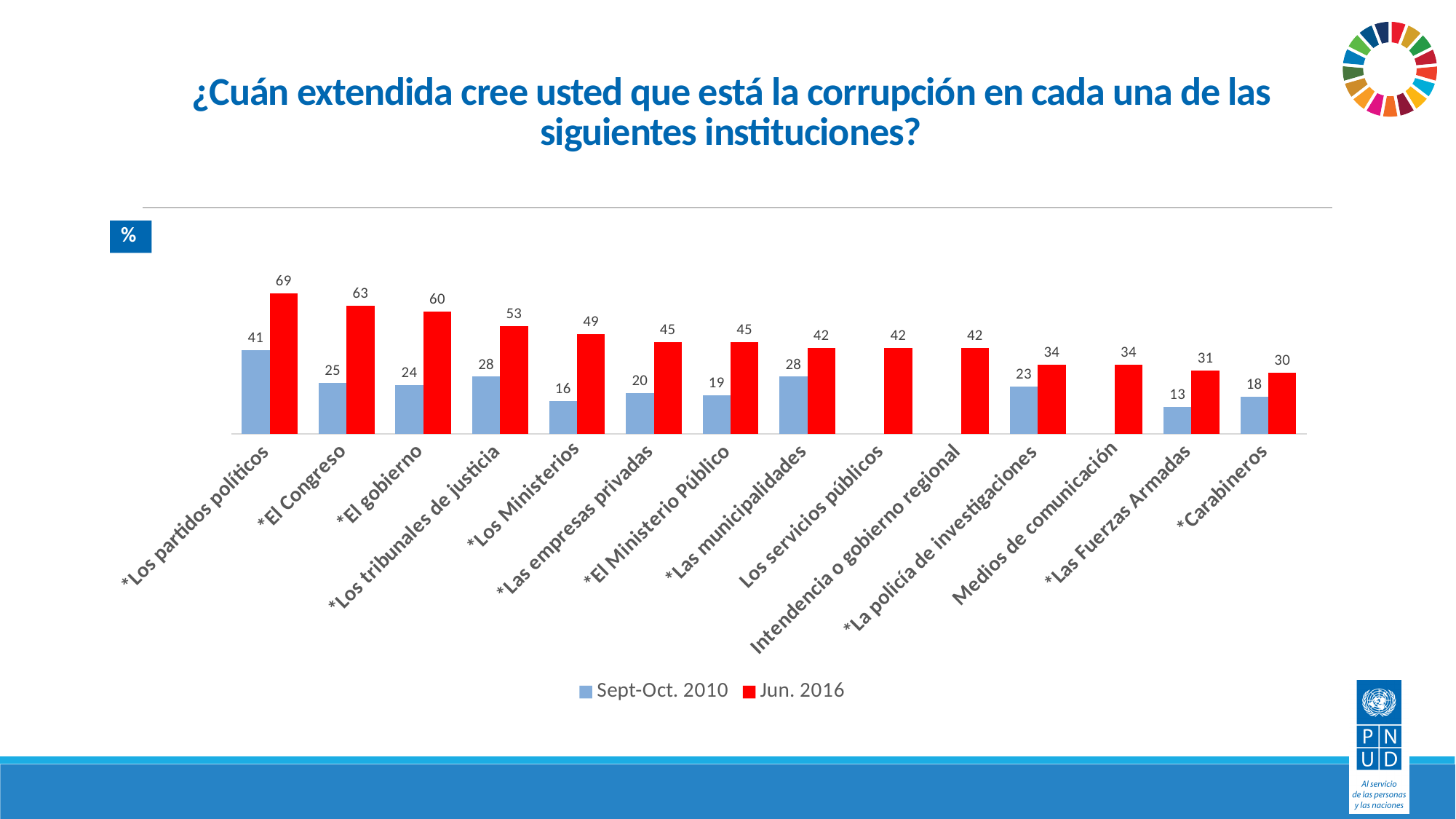
Which category has the highest Jun. 2016 value? *Los partidos políticos What is the difference between the Jun. 2016 and Sept-Oct. 2010 values for *Los Ministerios? 33 How many series does the legend list? 2 How many categories are shown on the x axis? 14 Which category has the lowest Sept-Oct. 2010 value? *Las Fuerzas Armadas What is the Jun. 2016 value for *Carabineros? 30 What is the Sept-Oct. 2010 value for *El Congreso? 25 Which colour represents the Jun. 2016 series? red What kind of chart is shown on the slide? bar chart Do the Jun. 2016 values generally rise or fall from left to right along the x axis? fall What is the Jun. 2016 value for *Los partidos políticos? 69 Which is larger, the Jun. 2016 value for *El gobierno or for *Los tribunales de justicia? *El gobierno